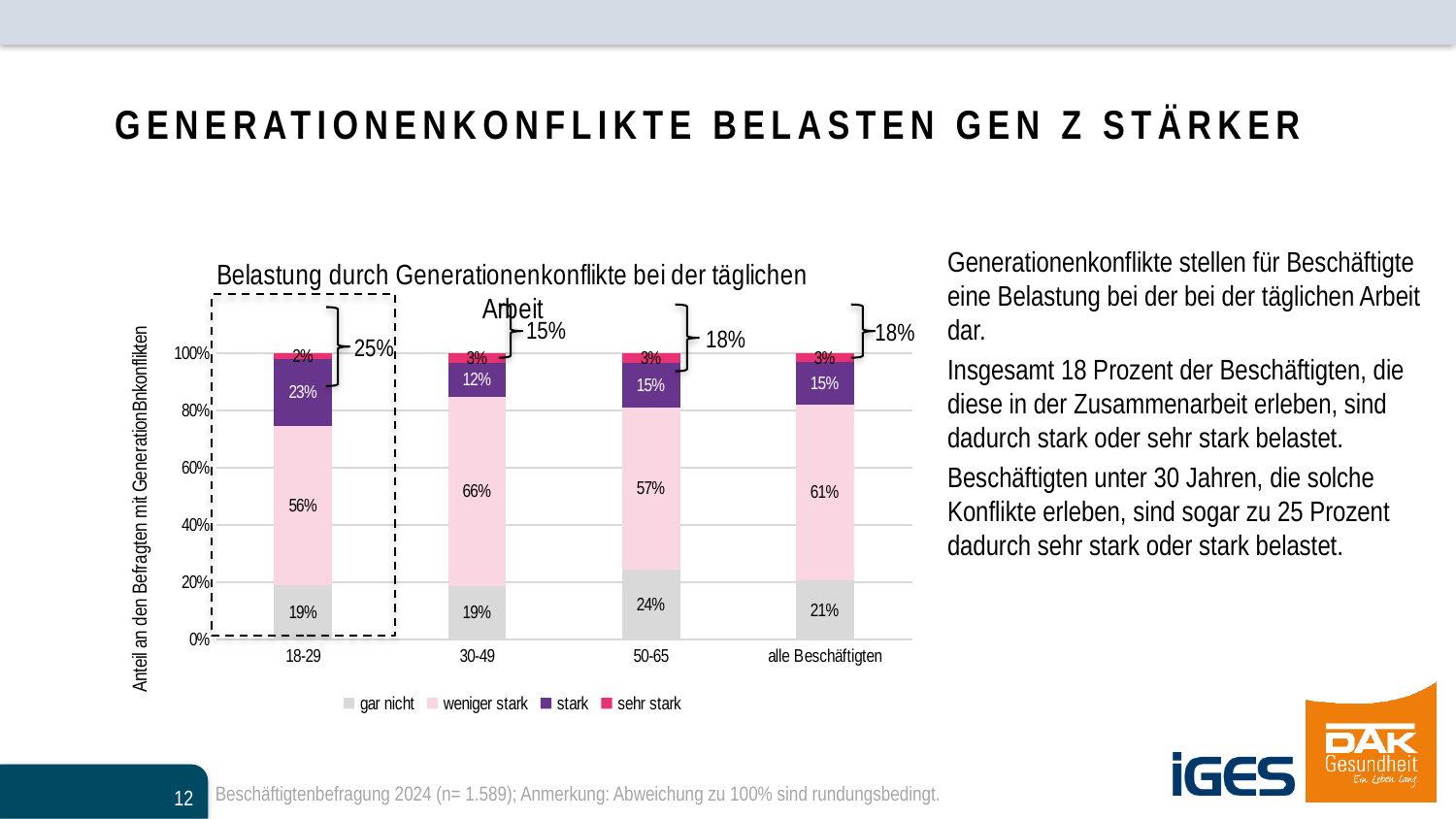
Which age group has the highest value for 'stark'? 18-29 What is the combined share of 'stark' and 'sehr stark' shown by the bracket above the 18-29 bar? 25% What is the value for 'stark' in the 18-29 group? 23% How many categories are shown on the x axis of the chart? 4 What is the value for 'weniger stark' in the 30-49 group? 66% How many series does the chart legend list? 4 What is the value for 'gar nicht' in the 50-65 group? 24% Which age group has the lowest value for 'weniger stark'? 18-29 What is the value for 'sehr stark' for 'alle Beschäftigten'? 3% Which is larger: the 'gar nicht' value for 50-65 or for 'alle Beschäftigten'? 50-65 What type of chart is shown on the slide? stacked bar chart What is the difference between the 'weniger stark' values for the 30-49 group and the 50-65 group? 9%